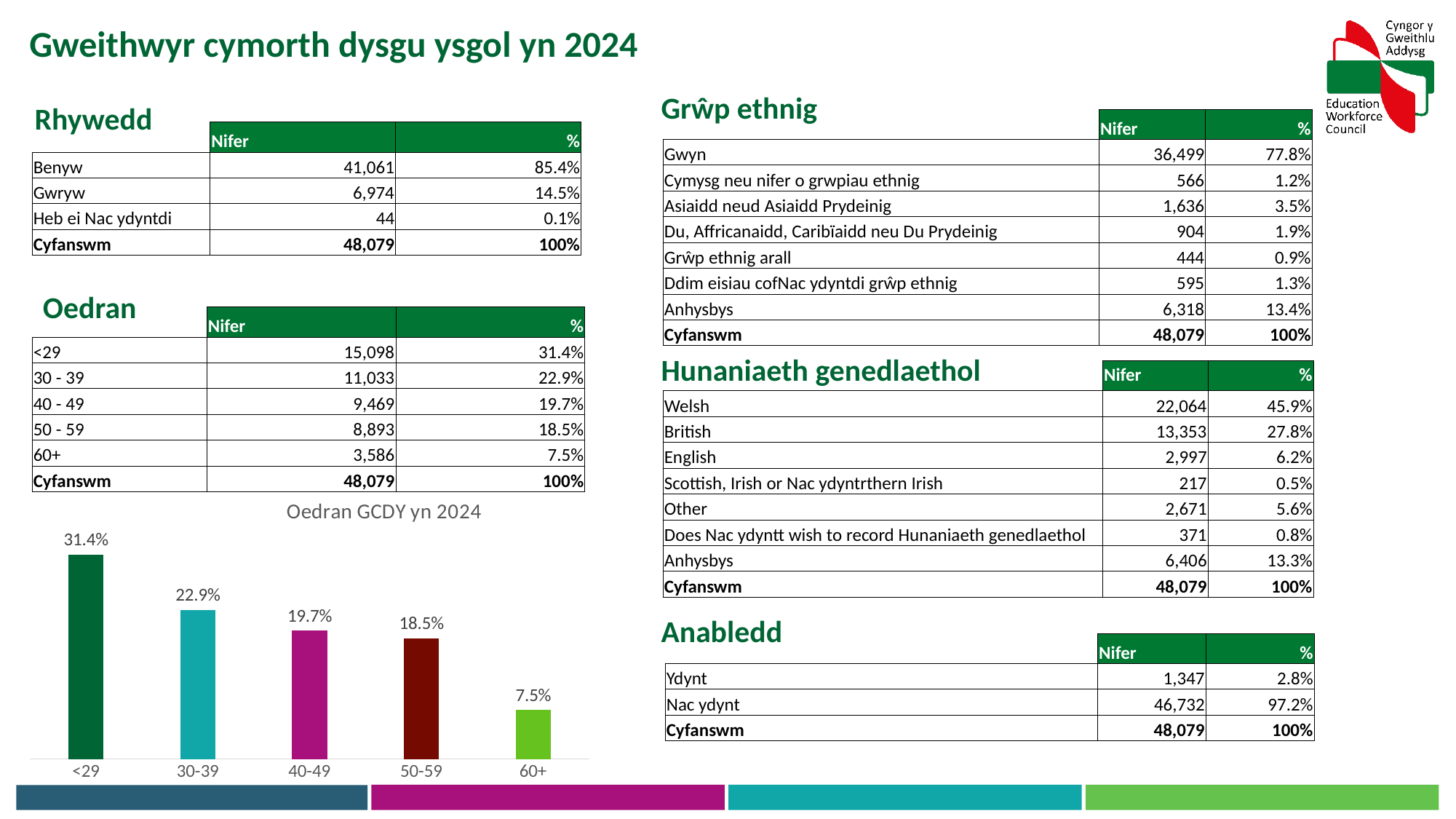
In the chart "Oedran GCDY yn 2024", which age group has the lowest value? 60+ In the chart "Oedran GCDY yn 2024", what is the value for <29? 31.4% In the chart "Oedran GCDY yn 2024", what is the value for 40-49? 19.7% In the chart "Oedran GCDY yn 2024", what is the difference between the values for 50-59 and 60+? 11.0% In the chart "Oedran GCDY yn 2024", what is the value for 60+? 7.5% What type of chart is "Oedran GCDY yn 2024"? bar chart What is the title of the bar chart on the slide? Oedran GCDY yn 2024 In the chart "Oedran GCDY yn 2024", which age group has the highest value? <29 In the chart "Oedran GCDY yn 2024", what is the difference between the values for <29 and 30-39? 8.5% In the chart "Oedran GCDY yn 2024", which is larger, the value for 30-39 or the value for 50-59? 30-39 How many age groups are shown in the chart "Oedran GCDY yn 2024"? 5 In the chart "Oedran GCDY yn 2024", do the values rise or fall from left to right along the x axis? fall